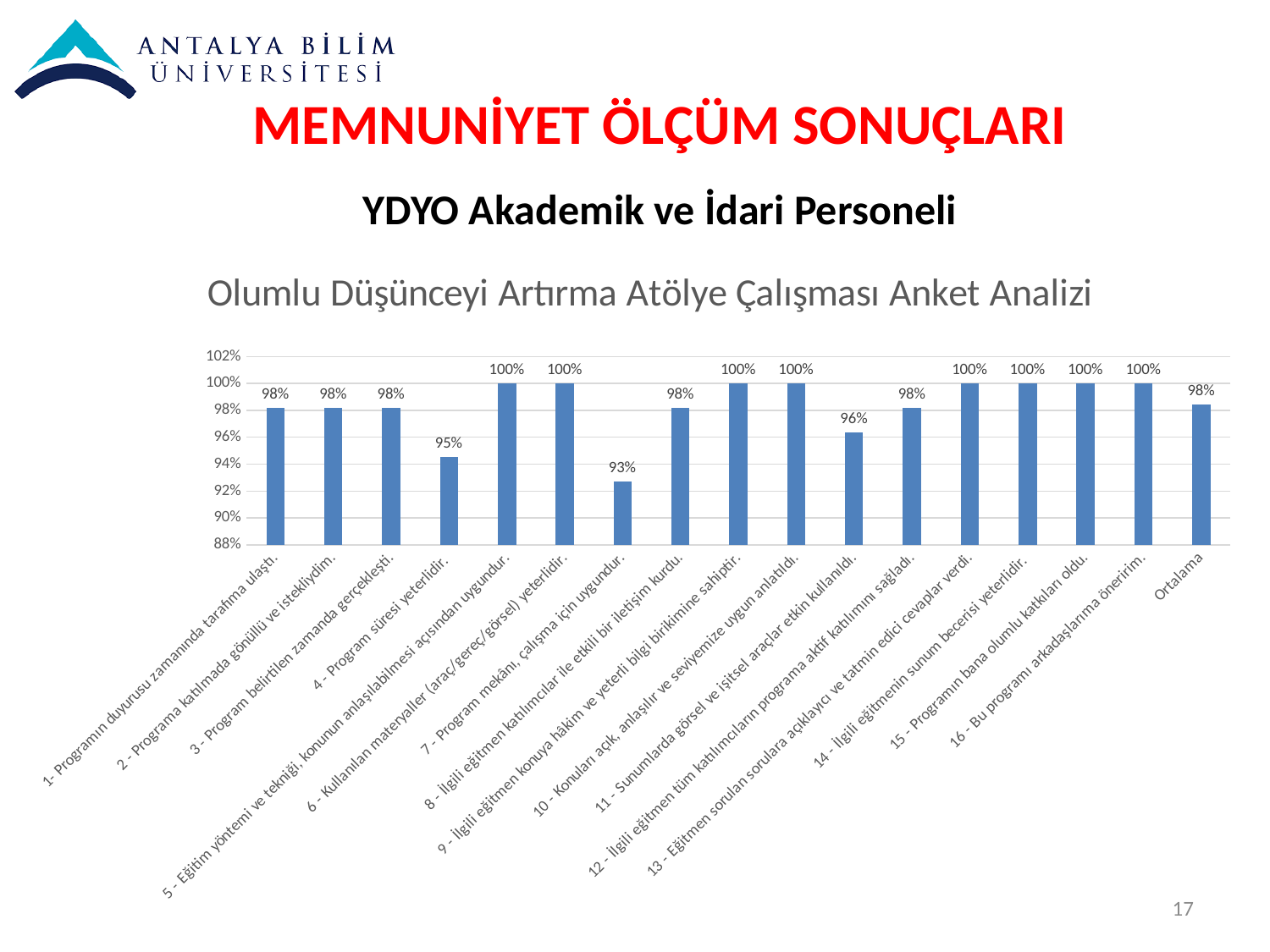
What is the value for "4 - Program süresi yeterlidir."? 95% What is the title of the chart? Olumlu Düşünceyi Artırma Atölye Çalışması Anket Analizi What kind of chart is shown on the slide? bar chart What is the value for "11 - Sunumlarda görsel ve işitsel araçlar etkin kullanıldı."? 96% Which category has the lowest value? 7 - Program mekânı, çalışma için uygundur. What is the difference between the value for "4 - Program süresi yeterlidir." and the value for "7 - Program mekânı, çalışma için uygundur."? 2% How many bars are plotted in the chart? 17 What is the value for "Ortalama"? 98% Is the value for "7 - Program mekânı, çalışma için uygundur." greater or less than 94%? less Which is larger: the value for "4 - Program süresi yeterlidir." or the value for "11 - Sunumlarda görsel ve işitsel araçlar etkin kullanıldı."? 11 - Sunumlarda görsel ve işitsel araçlar etkin kullanıldı. What is the value for "7 - Program mekânı, çalışma için uygundur."? 93% What is the difference between the value for "5 - Eğitim yöntemi ve tekniği, konunun anlaşılabilmesi açısından uygundur." and the value for "11 - Sunumlarda görsel ve işitsel araçlar etkin kullanıldı."? 4%